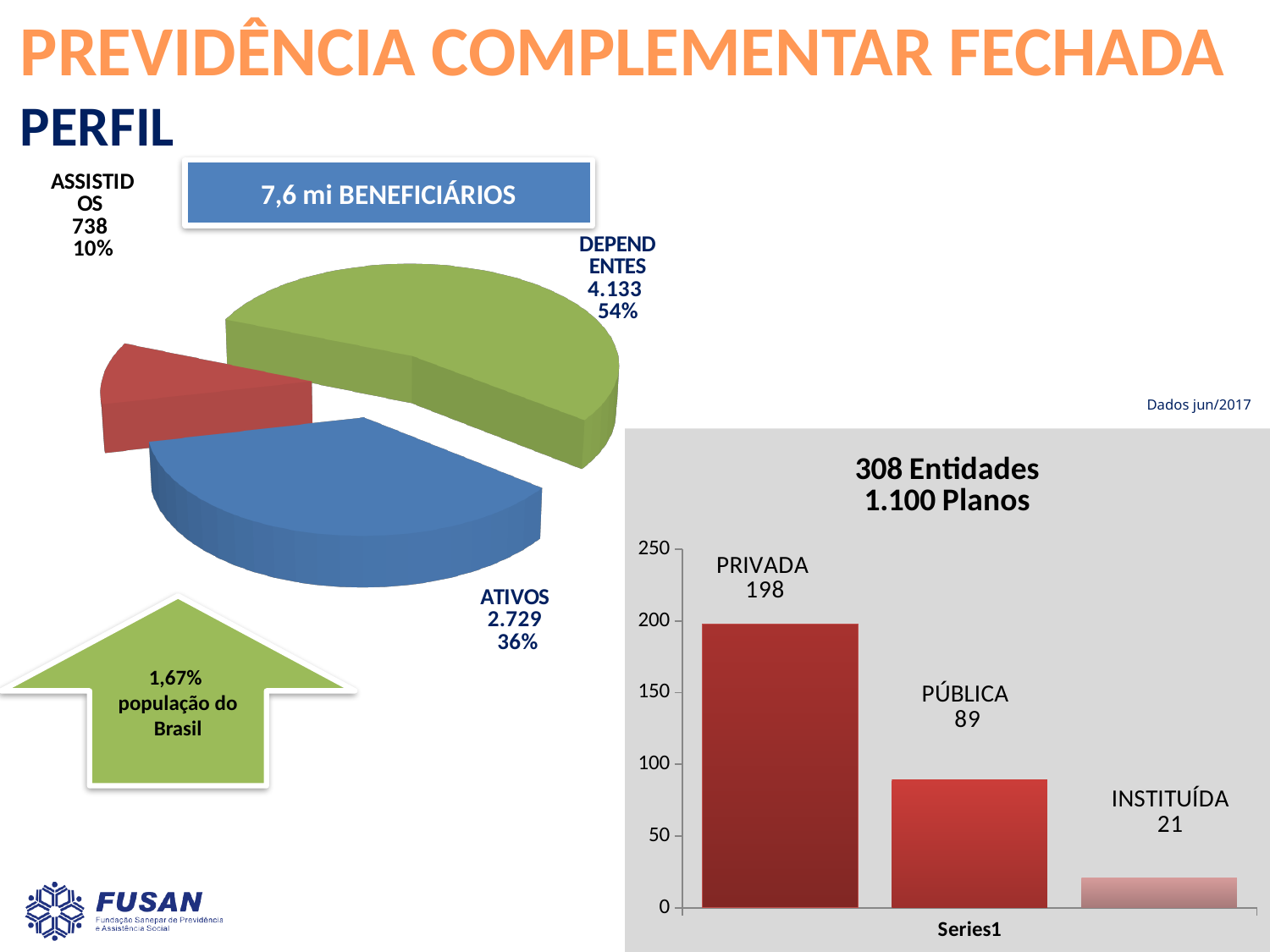
In the pie chart on the left, which category has the largest slice? DEPENDENTES In the pie chart on the left, what percentage share is shown for ATIVOS? 36% In the chart titled '308 Entidades 1.100 Planos', what is the difference between PRIVADA and PÚBLICA? 109 In the chart titled '308 Entidades 1.100 Planos', which category has the highest value? PRIVADA How many slices does the pie chart on the left have? 3 In the pie chart on the left, what value is shown for DEPENDENTES? 4.133 In the chart titled '308 Entidades 1.100 Planos', what is the value for PÚBLICA? 89 In the pie chart on the left, which category has the smallest slice? ASSISTIDOS What kind of chart is the chart titled '308 Entidades 1.100 Planos'? bar chart In the chart titled '308 Entidades 1.100 Planos', how many bars are plotted? 3 In the chart titled '308 Entidades 1.100 Planos', what is the value for INSTITUÍDA? 21 In the pie chart on the left, what percentage share is shown for ASSISTIDOS? 10%